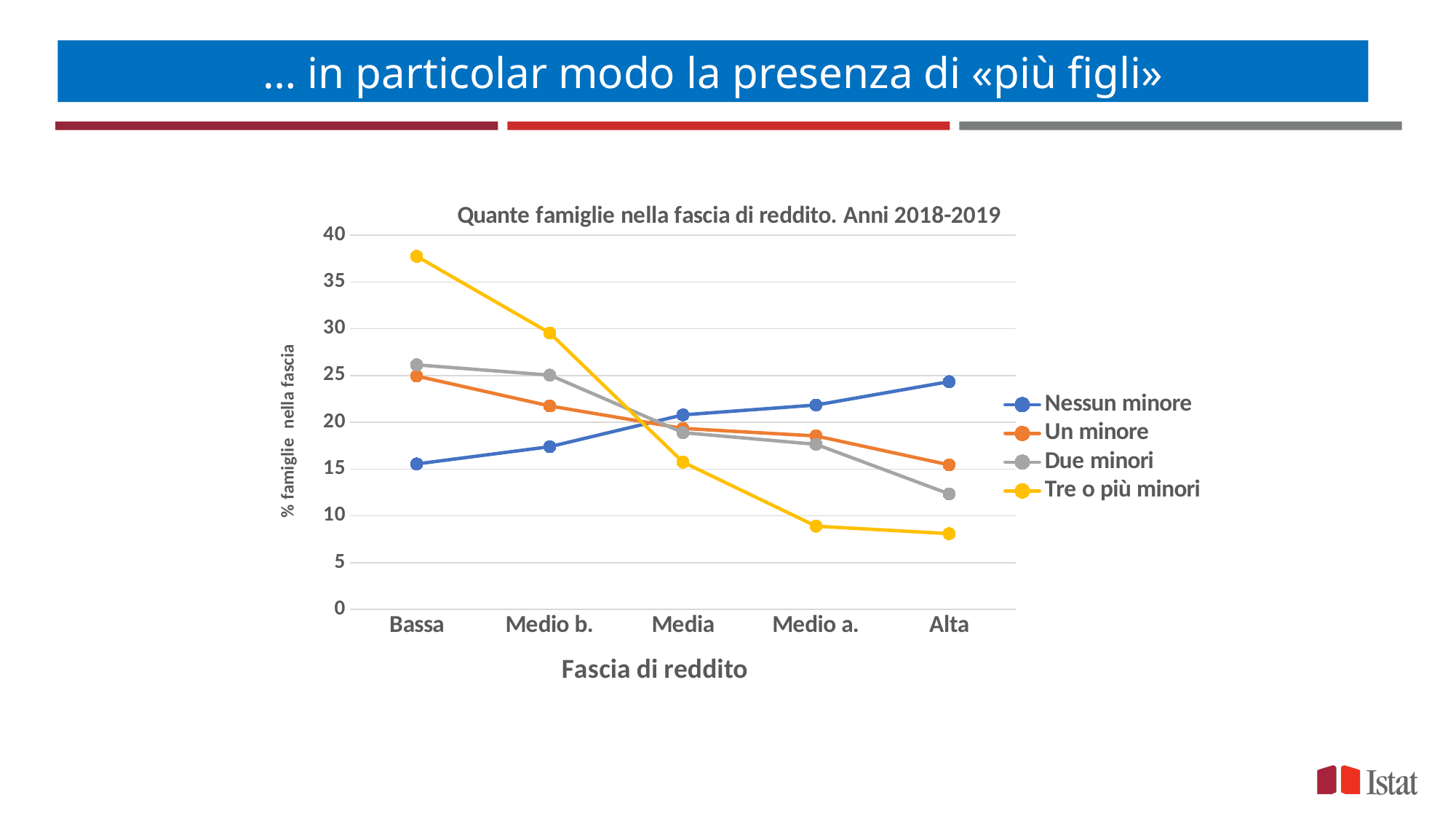
Which series has the lowest value in the Alta income band? Tre o più minori Is the value for 'Tre o più minori' in the Bassa band greater or less than 35? greater What kind of chart is shown on the slide? Line chart In the Alta income band, which is larger: 'Nessun minore' or 'Un minore'? Nessun minore In which income band does 'Nessun minore' reach its highest value? Alta What is the title of the chart? Quante famiglie nella fascia di reddito. Anni 2018-2019 Which series has the highest value in the Bassa income band? Tre o più minori How many series does the legend list? 4 Does the 'Nessun minore' line rise or fall from Bassa to Alta? Rise How many income bands (categories) are shown on the x axis? 5 Is the value for 'Tre o più minori' in the Medio a. band greater or less than 10? less Does the 'Tre o più minori' line rise or fall from Bassa to Alta? Fall